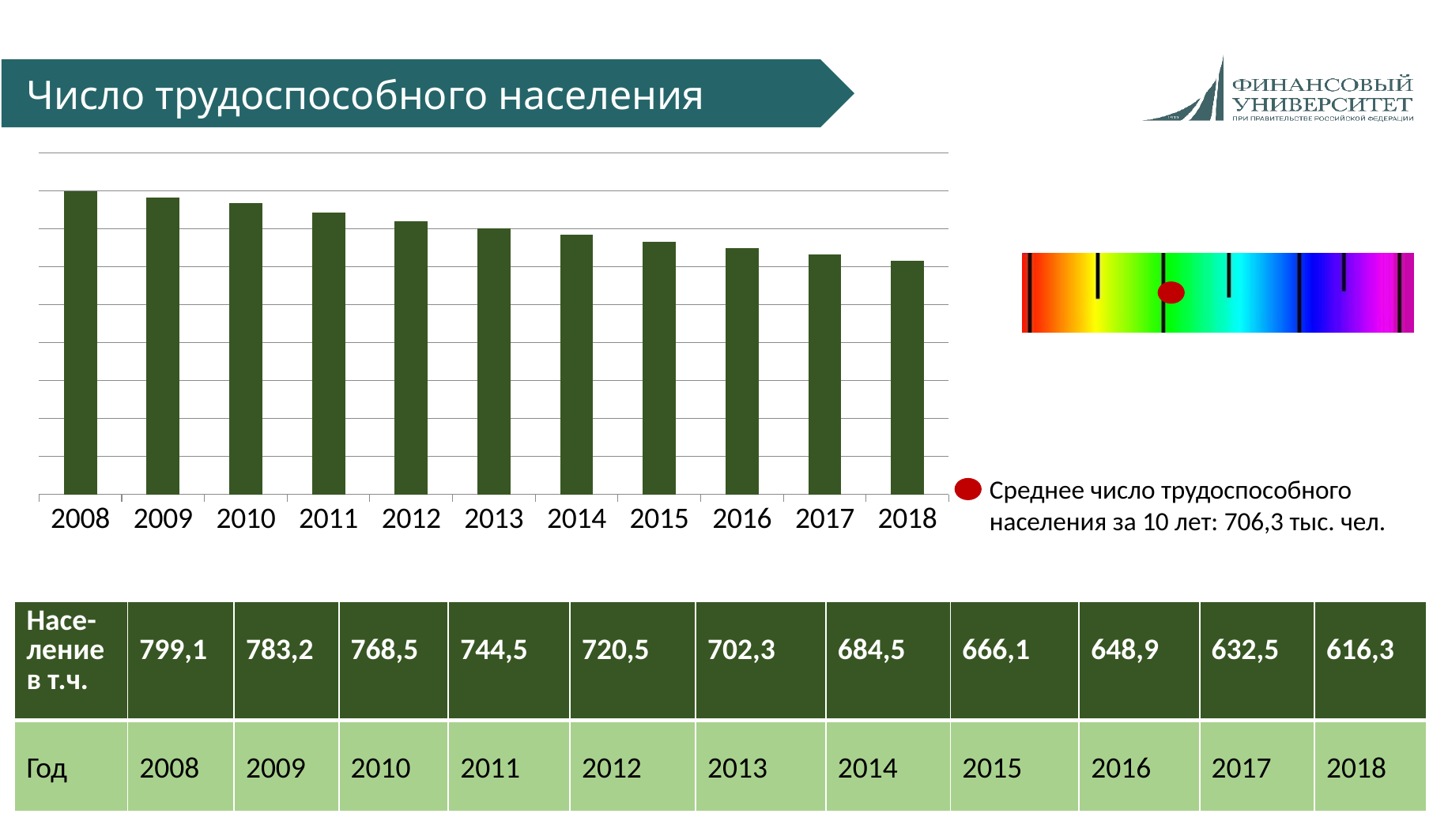
Which year has the highest value on the bar chart? 2008 According to the table, what is the population value for 2013? 702,3 What kind of chart is shown on the slide? bar chart What average value over 10 years is stated next to the red dot? 706,3 тыс. чел. Is the bar for 2010 taller or shorter than the bar for 2015? taller Do the values rise or fall from 2008 to 2018? fall Which year has the lowest value on the bar chart? 2018 According to the table, what is the population value for 2008? 799,1 What is the title of the slide's chart? Число трудоспособного населения According to the table, what is the population value for 2018? 616,3 What is the difference between the values for 2008 and 2018 shown in the table? 182,8 How many years are plotted on the bar chart? 11